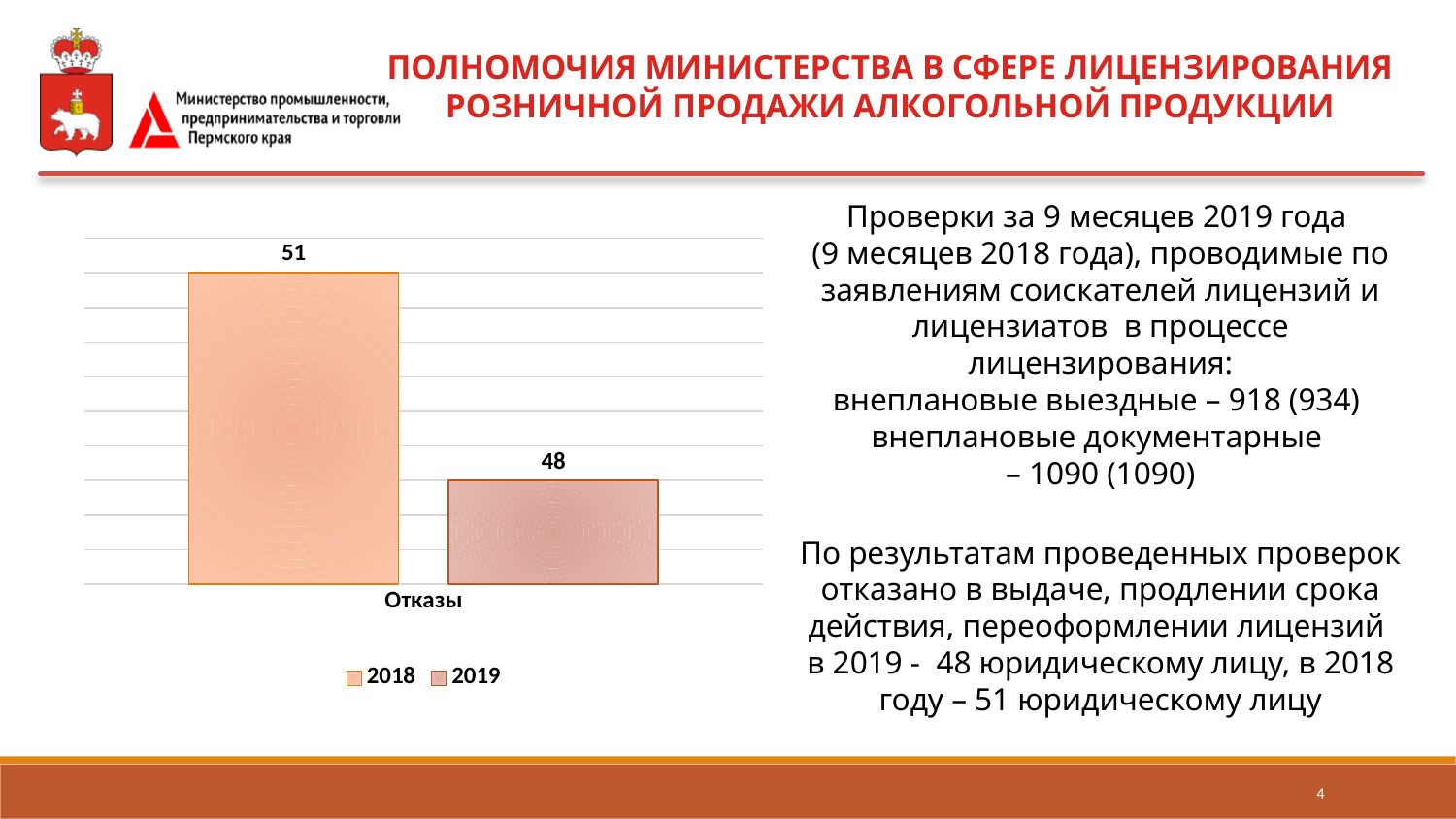
How many series does the legend list? 2 What is the difference between the 2018 and 2019 values for Отказы? 3 What is the value for 2019 in the Отказы chart? 48 Which series has the higher value for Отказы, 2018 or 2019? 2018 How many categories are shown on the x axis of the chart? 1 What kind of chart is shown on the slide? bar chart Which series is shown in the lighter orange colour in the chart? 2018 What is the value for 2018 in the Отказы chart? 51 Did the value for Отказы rise or fall from 2018 to 2019? fall Which series has the lowest value in the chart? 2019 What is the category label on the x axis of the chart? Отказы